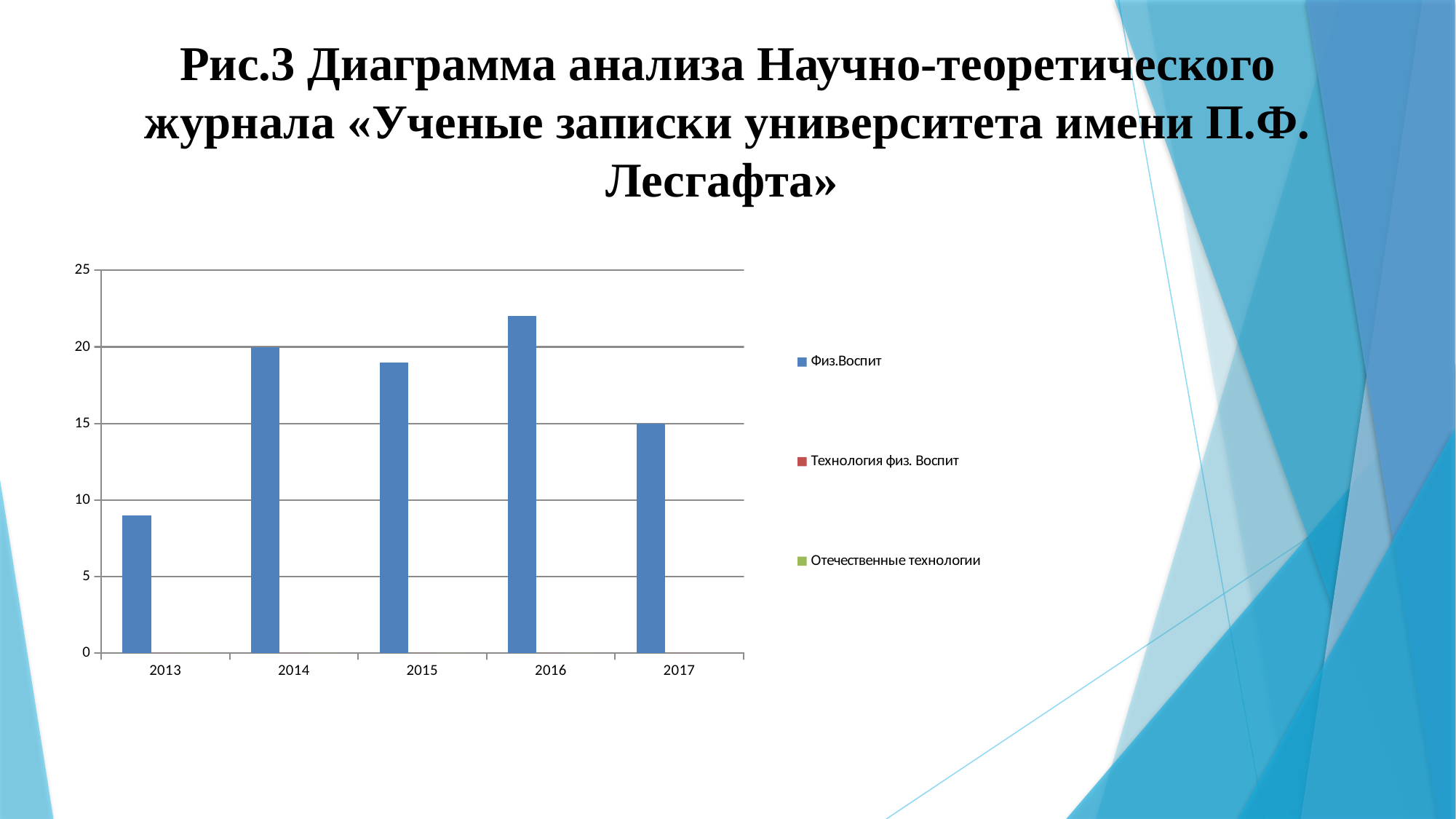
What is the difference between the values for 2014 and 2017? 5 What is the value of the bar for 2014? 20 How many series does the chart legend list? 3 How many years are shown on the x axis of the chart? 5 Is the value for 2016 greater or less than 20? greater What is the value of the bar for 2017? 15 What type of chart is shown on the slide? bar chart Is the value for 2013 greater or less than 10? less Which year has the highest bar in the chart? 2016 Which year has the lowest bar in the chart? 2013 Which year has the larger value, 2014 or 2017? 2014 Which series is listed first in the chart legend? Физ.Воспит